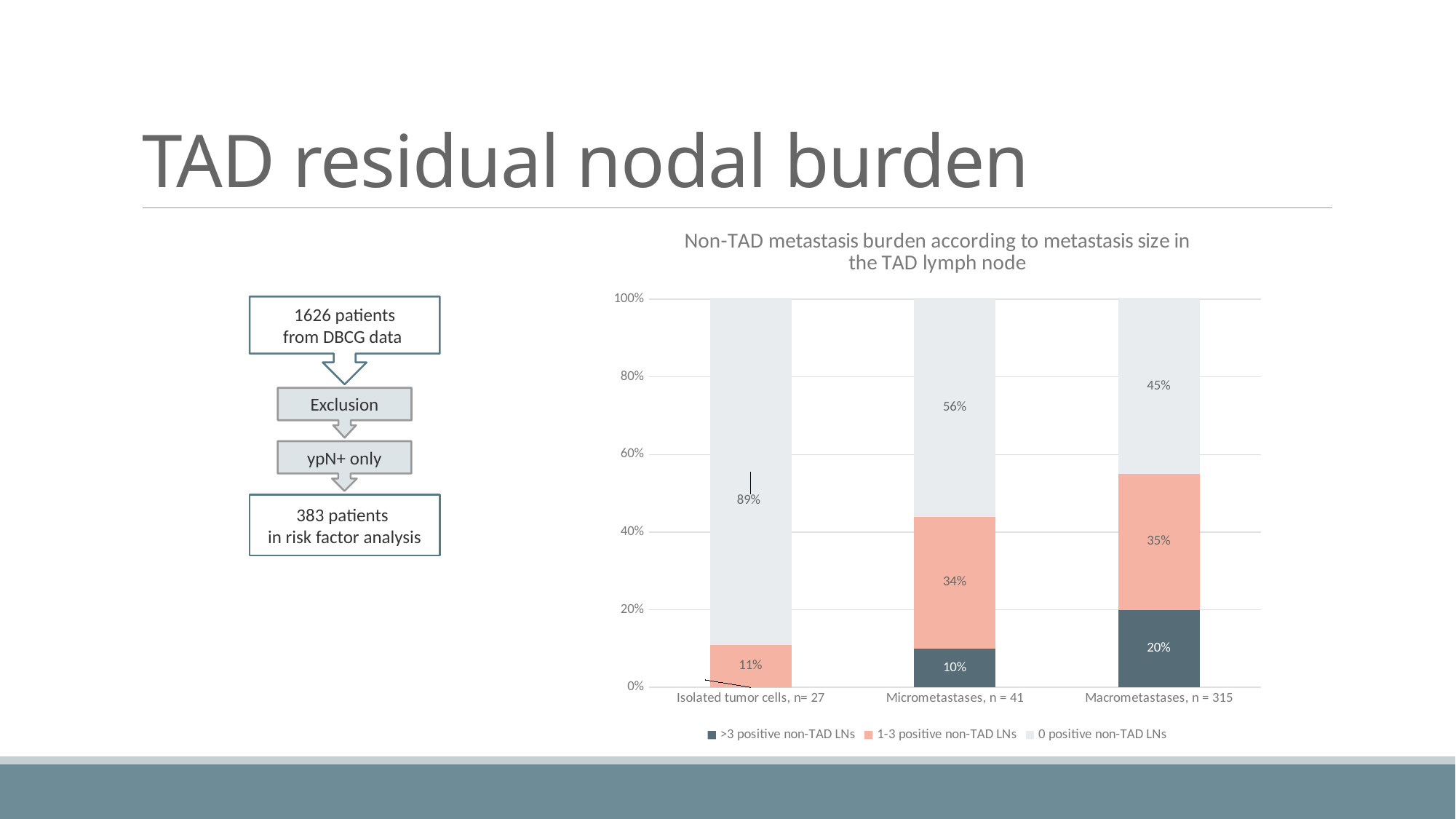
What is the difference between the '0 positive non-TAD LNs' values for 'Micrometastases, n = 41' and 'Macrometastases, n = 315'? 11% What is the title of the chart? Non-TAD metastasis burden according to metastasis size in the TAD lymph node What is the value for '1-3 positive non-TAD LNs' in the 'Isolated tumor cells, n= 27' bar? 11% How many series does the legend list? 3 Which category has the highest value for '>3 positive non-TAD LNs'? Macrometastases, n = 315 How many categories are shown on the x axis? 3 What kind of chart is shown on the slide? Stacked bar chart Which is larger: the '1-3 positive non-TAD LNs' value for 'Micrometastases, n = 41' or for 'Isolated tumor cells, n= 27'? Micrometastases, n = 41 What is the value for '0 positive non-TAD LNs' in the 'Isolated tumor cells, n= 27' bar? 89% What is the value for '0 positive non-TAD LNs' in the 'Micrometastases, n = 41' bar? 56% What is the value for '>3 positive non-TAD LNs' in the 'Macrometastases, n = 315' bar? 20% Which category has the lowest value for '0 positive non-TAD LNs'? Macrometastases, n = 315